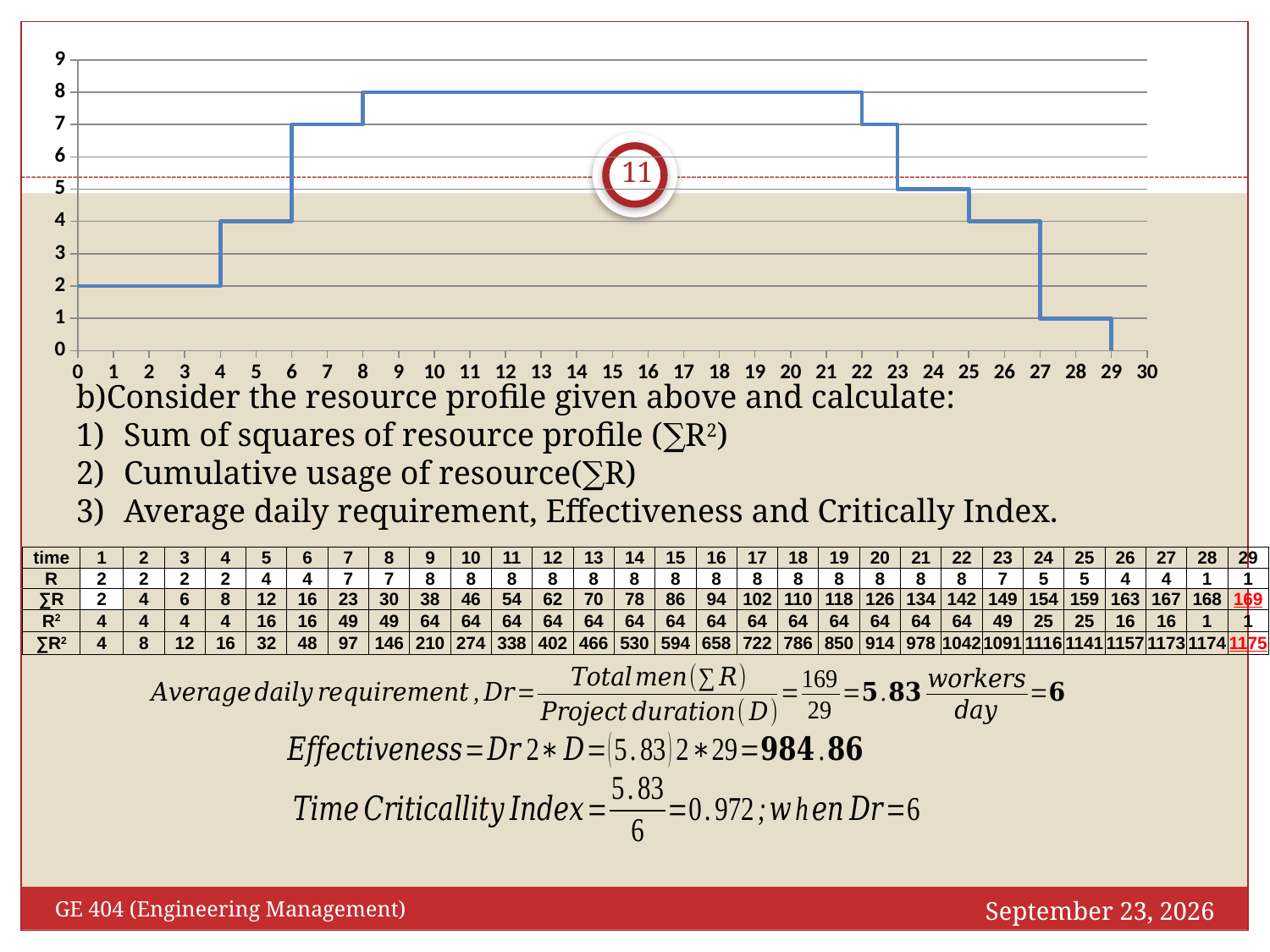
What is the largest value labelled on the y axis of the resource profile chart? 9 Which is larger in the resource profile chart: the value at time 5 or the value at time 7? time 7 What kind of chart is shown at the top of the slide? line chart What is the value of the resource profile line at time 10? 8 Between time 22 and time 29, does the resource profile line rise or fall? fall What is the highest value reached by the line in the resource profile chart? 8 What is the value of the resource profile line at time 24? 5 What is the value of the resource profile line at time 28? 1 What is the value of the resource profile line at time 2? 2 Is the value of the resource profile line at time 15 greater or less than 5? greater Is the value of the resource profile line at time 3 greater or less than 5? less By how much does the value of the resource profile line at time 10 exceed the value at time 2? 6